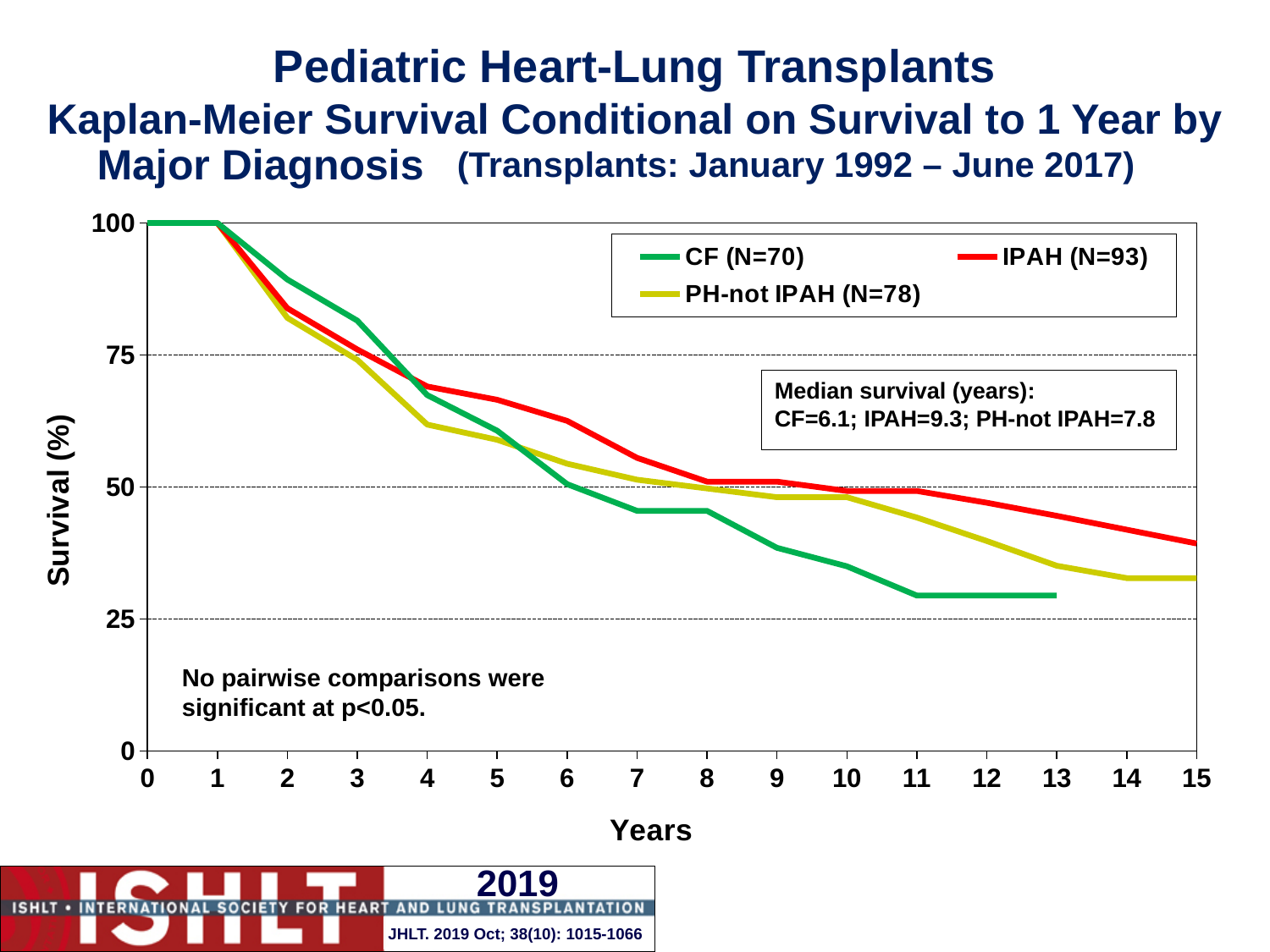
How many series does the legend list? 3 At 15 years, which series shows higher survival: IPAH or PH-not IPAH? IPAH Which diagnosis group has the highest median survival? IPAH What is the median survival in years for the IPAH group? 9.3 How many patients (N) are in the IPAH group according to the legend? 93 Is the survival value for IPAH at 15 years greater or less than 25? greater Which diagnosis group has the lowest median survival? CF What is the median survival in years for the PH-not IPAH group? 7.8 What is the difference in median survival (years) between IPAH and CF? 3.2 Is the survival value for CF at 13 years greater or less than 50? less What kind of chart is shown on the slide? Line chart What is the median survival in years for the CF group? 6.1